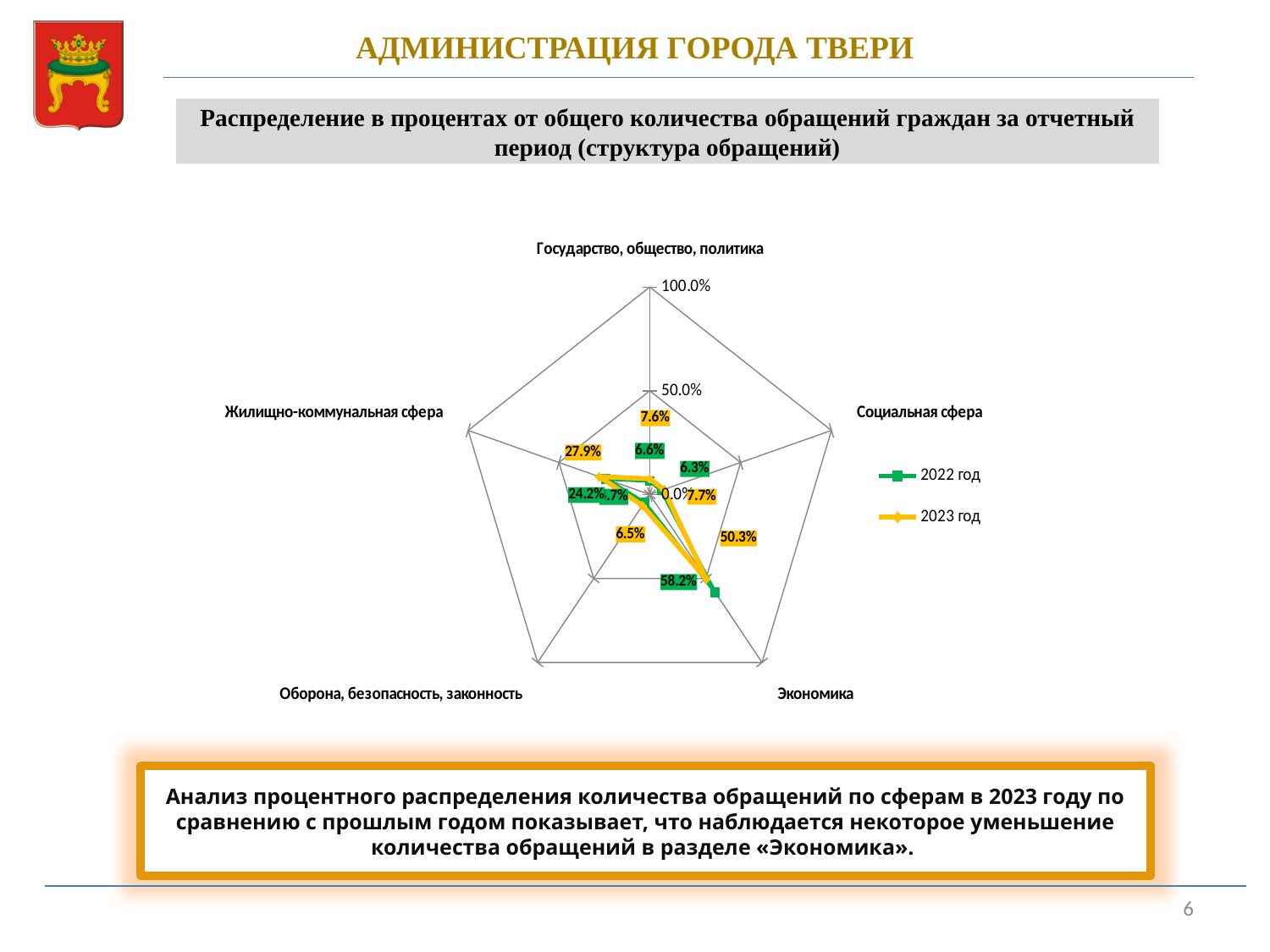
What kind of chart is shown on the slide? Radar chart For Социальная сфера, which year has the larger value, 2022 год or 2023 год? 2023 год What is the value for Государство, общество, политика in 2023 год? 7.6% What is the value for Жилищно-коммунальная сфера in 2023 год? 27.9% What is the value for Жилищно-коммунальная сфера in 2022 год? 24.2% By how many percentage points did the value for Экономика change from 2022 год to 2023 год? 7.9 percentage points lower How many series does the chart legend list? 2 What is the value for Экономика in 2022 год? 58.2% How many categories (axes) does the radar chart have? 5 What is the value for Экономика in 2023 год? 50.3% What colour represents the 2023 год series? Yellow Which category has the highest value for 2023 год? Экономика